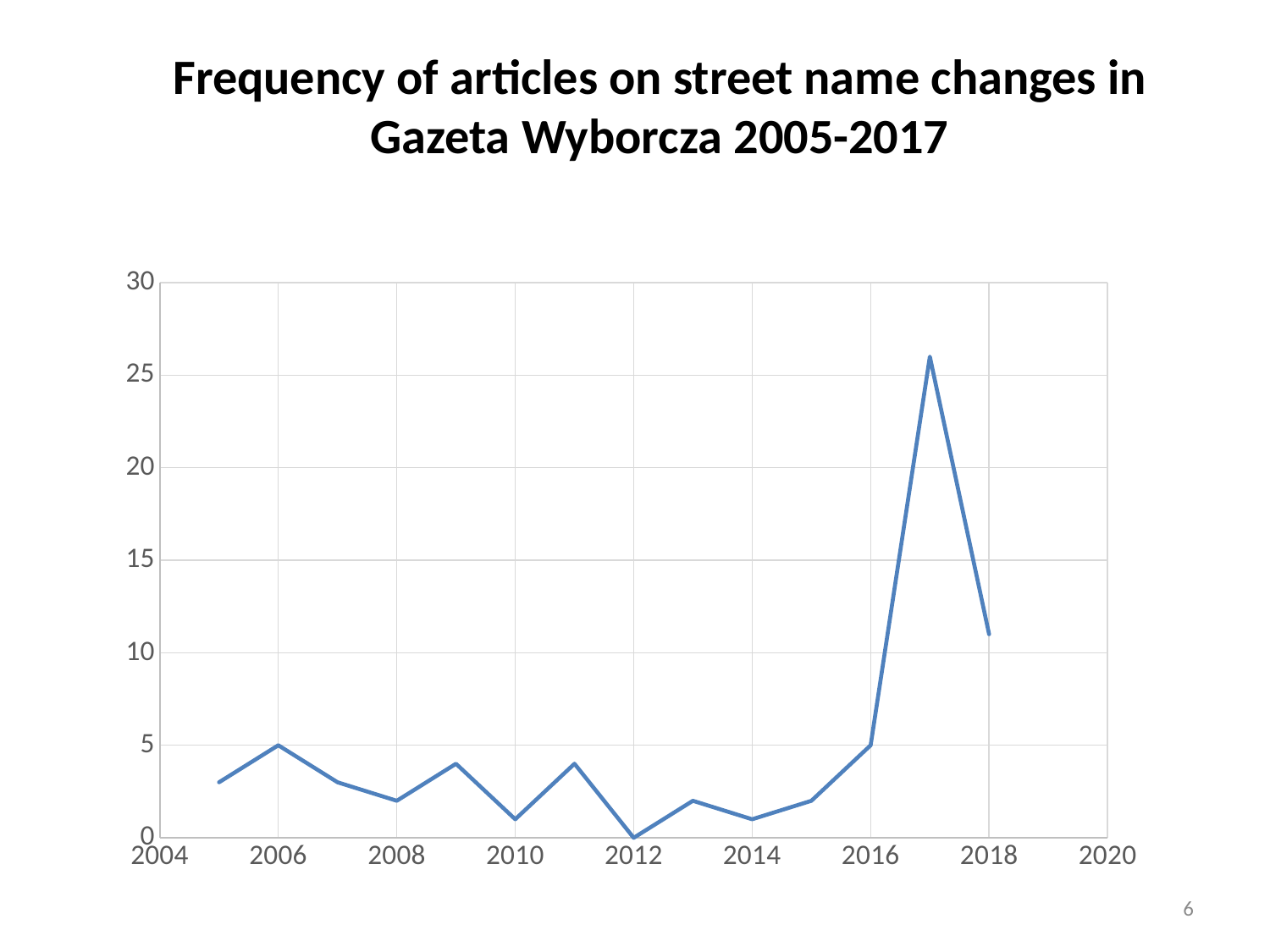
Is the value for 2018 greater or less than 10? greater Which year has the highest value on the chart? 2017 Is the value for 2017 greater or less than 25? greater What is the value for 2012? 0 Does the line rise or fall between 2016 and 2017? rise Is the value for 2010 greater or less than 5? less What kind of chart is shown on the slide? line chart Which year has the lowest value on the chart? 2012 What is the title of the chart? Frequency of articles on street name changes in Gazeta Wyborcza 2005-2017 What is the value for 2016? 5 Which year has the larger value, 2017 or 2018? 2017 What is the value for 2006? 5